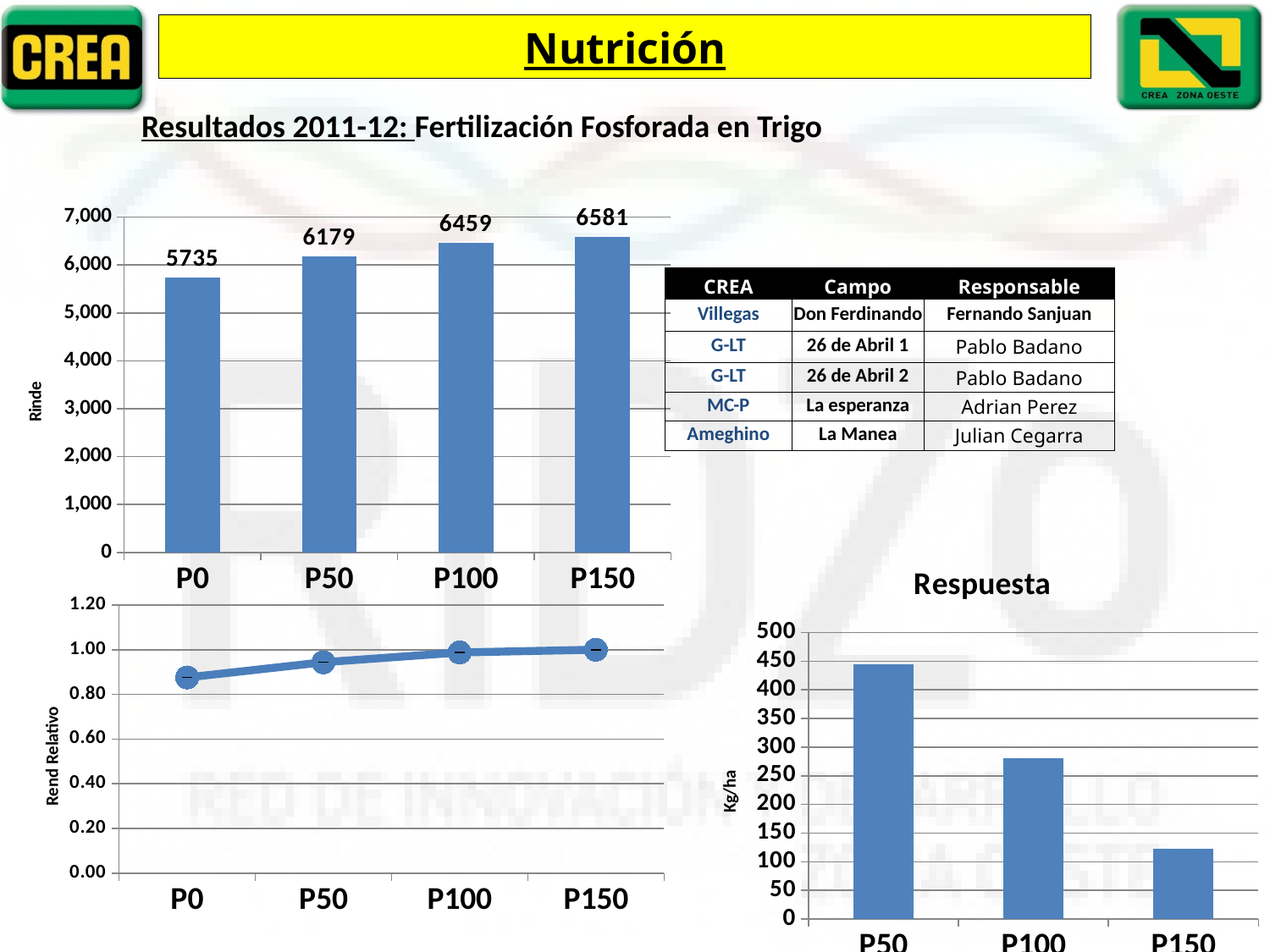
In the top-left bar chart (Rinde), what is the difference between the values for P100 and P50? 280 In the top-left bar chart (Rinde), what is the value for P0? 5735 What is the y-axis label of the bottom-right chart titled Respuesta? Kg/ha In the top-left bar chart (Rinde), do the values rise or fall from P0 to P150? rise In the bottom-right chart titled Respuesta, which category has the highest value? P50 What kind of chart is the bottom-left chart (Rend Relativo)? line chart In the top-left bar chart (Rinde), what is the value for P150? 6581 In the top-left bar chart (Rinde), which category has the highest value? P150 In the bottom-left line chart (Rend Relativo), is the value for P0 greater or less than 0.80? greater In the top-left bar chart (Rinde), how many categories are shown on the x axis? 4 In the bottom-right chart titled Respuesta, is the value for P150 greater or less than 150? less In the top-left bar chart (Rinde), which category has the lowest value? P0